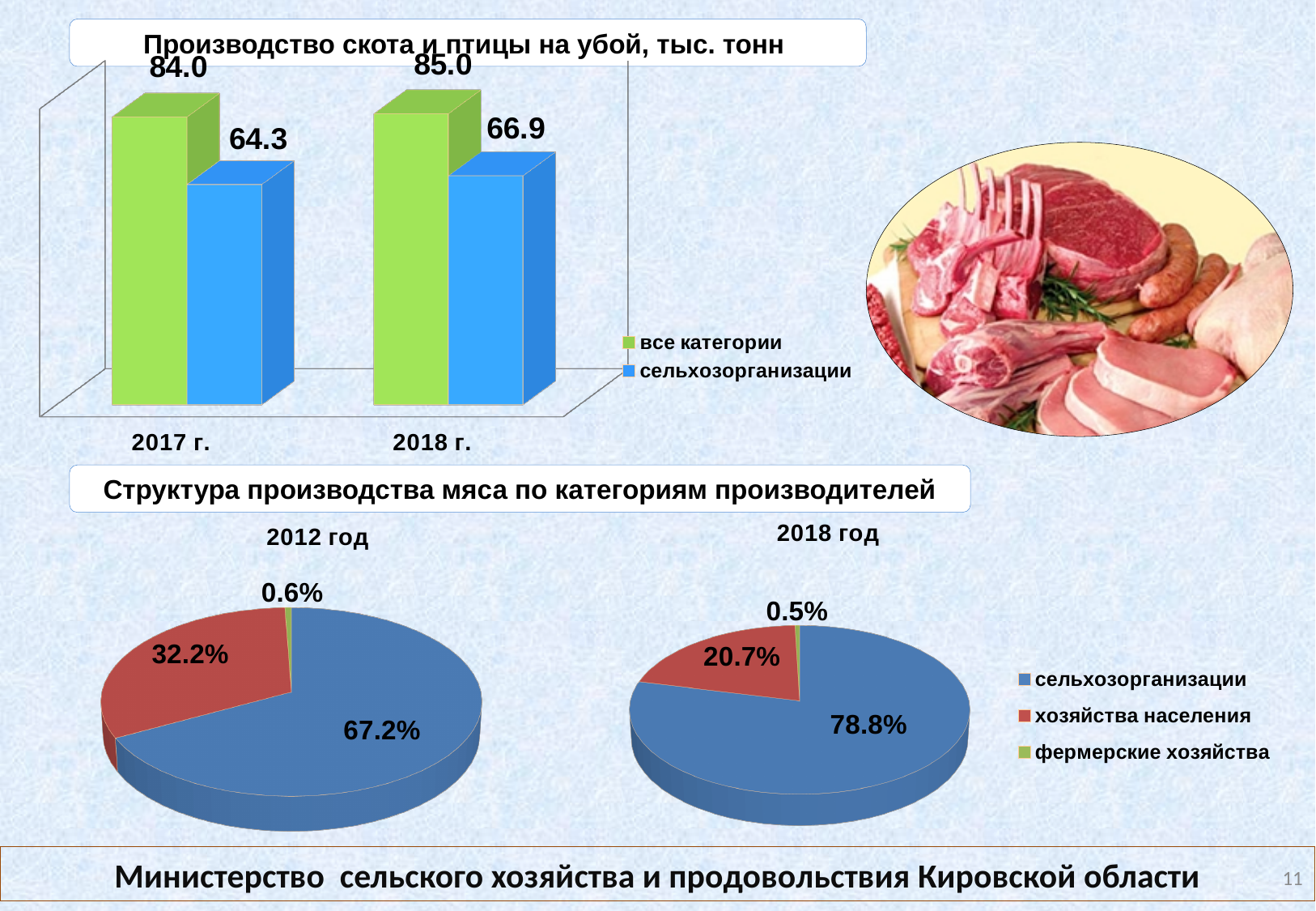
How many categories does the legend of the pie charts list? 3 In the 2018 год pie chart, which category has the smallest share? фермерские хозяйства In the bar chart 'Производство скота и птицы на убой, тыс. тонн', what is the difference between 'все категории' and 'сельхозорганизации' in 2017 г.? 19.7 In the bar chart 'Производство скота и птицы на убой, тыс. тонн', how many series does the legend list? 2 In the 2012 год pie chart, which category has the largest share? сельхозорганизации In the bar chart 'Производство скота и птицы на убой, тыс. тонн', what is the value for 'все категории' in 2017 г.? 84.0 What kind of chart is the top chart 'Производство скота и птицы на убой, тыс. тонн'? bar chart Which is larger: the share of 'хозяйства населения' in the 2012 год pie chart or in the 2018 год pie chart? 2012 год In the bar chart 'Производство скота и птицы на убой, тыс. тонн', what is the value for 'сельхозорганизации' in 2018 г.? 66.9 In the 2018 год pie chart, what share does 'сельхозорганизации' have? 78.8% In the 2012 год pie chart, what share does 'хозяйства населения' have? 32.2% In the bar chart 'Производство скота и птицы на убой, тыс. тонн', does the value for 'сельхозорганизации' rise or fall from 2017 г. to 2018 г.? rise